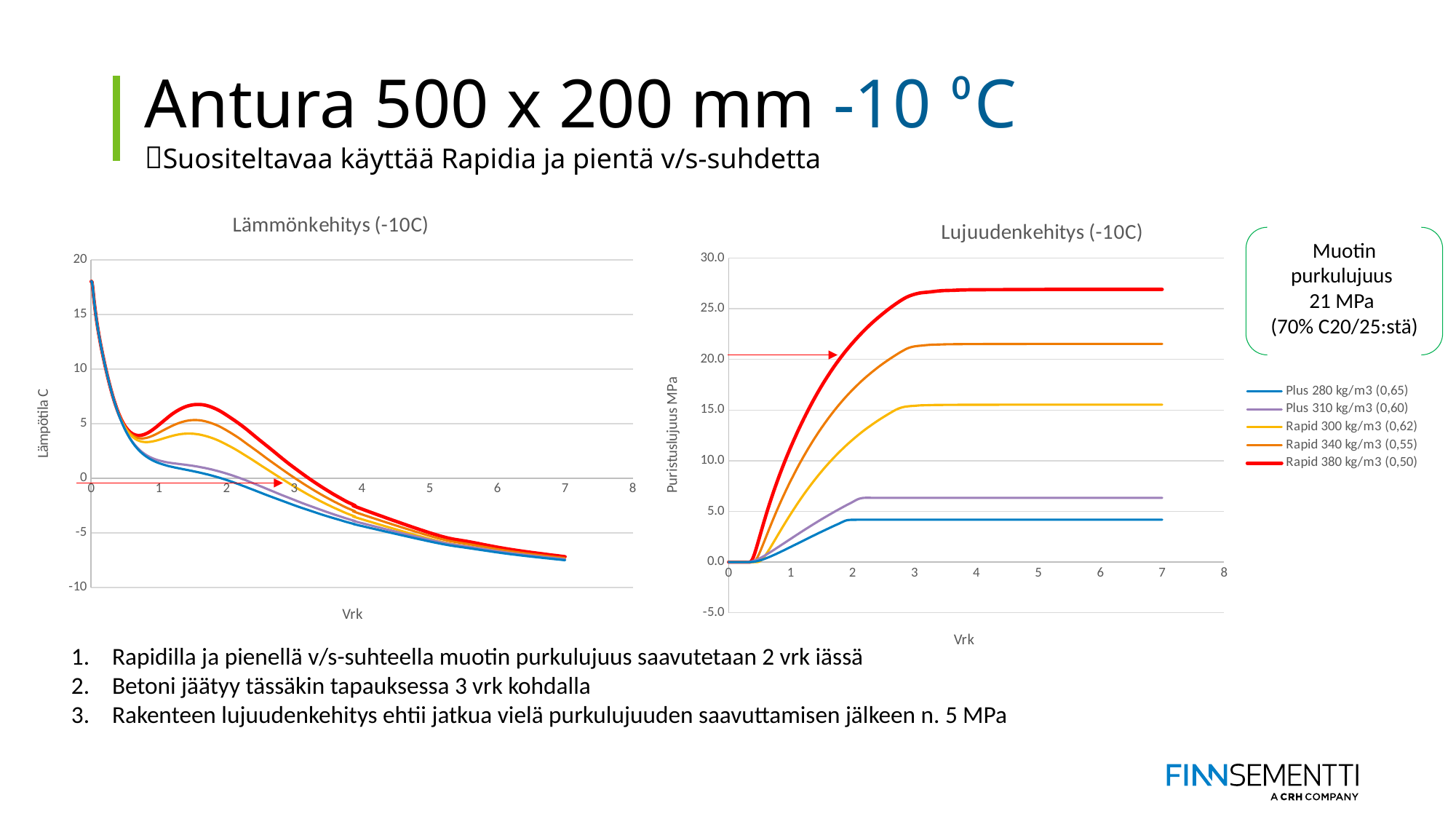
In the left chart "Lämmönkehitys (-10C)", do the temperature curves rise or fall between day 3 and day 7? fall In the right chart "Lujuudenkehitys (-10C)", is the final strength of Rapid 300 kg/m3 (0,62) greater or less than 20.0? less In the right chart "Lujuudenkehitys (-10C)", which has the higher strength at day 7: Rapid 340 kg/m3 (0,55) or Rapid 300 kg/m3 (0,62)? Rapid 340 kg/m3 (0,55) What kind of chart is the left chart titled "Lämmönkehitys (-10C)"? line chart In the left chart "Lämmönkehitys (-10C)", which series has the highest temperature peak around day 1.5? Rapid 380 kg/m3 (0,50) What is the y-axis label of the right chart "Lujuudenkehitys (-10C)"? Puristuslujuus MPa In the right chart "Lujuudenkehitys (-10C)", is the final strength of Plus 310 kg/m3 (0,60) greater or less than 5.0? greater In the right chart "Lujuudenkehitys (-10C)", which series has the lowest final strength? Plus 280 kg/m3 (0,65) In the right chart "Lujuudenkehitys (-10C)", is the final strength of Rapid 380 kg/m3 (0,50) greater or less than 25.0? greater How many series does the legend list for the charts? 5 In the right chart "Lujuudenkehitys (-10C)", which series reaches the highest compressive strength? Rapid 380 kg/m3 (0,50)